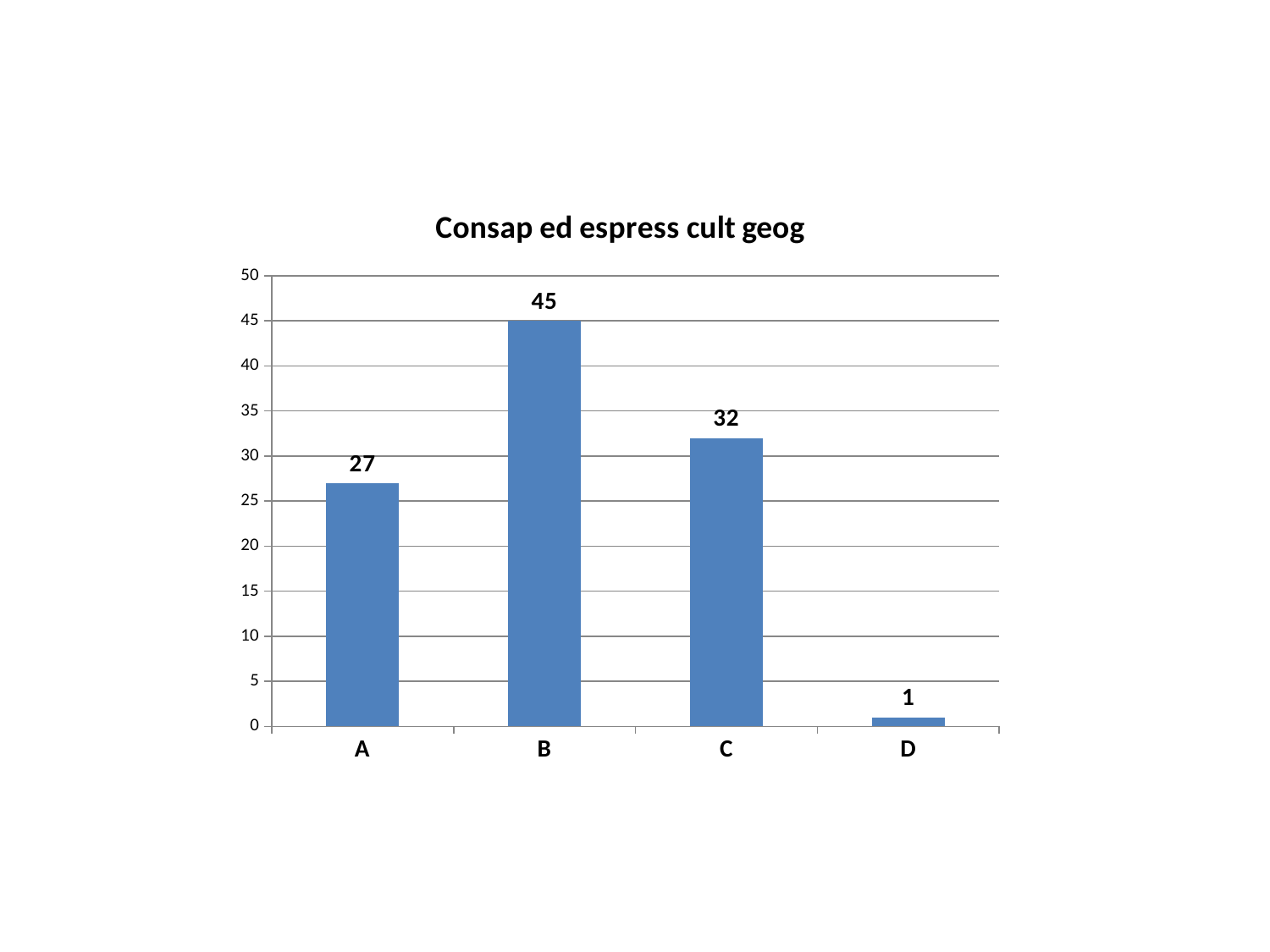
What is the value for category A? 27 What kind of chart is shown on the slide? bar chart Which is larger, the value for A or the value for C? C How many categories are shown on the x axis? 4 Which category has the lowest value? D Which category has the highest value? B What is the value for category D? 1 What is the difference between the values for B and C? 13 What is the title of the chart? Consap ed espress cult geog What is the value for category B? 45 What is the difference between the values for A and D? 26 Is the value for C greater or less than 30? greater